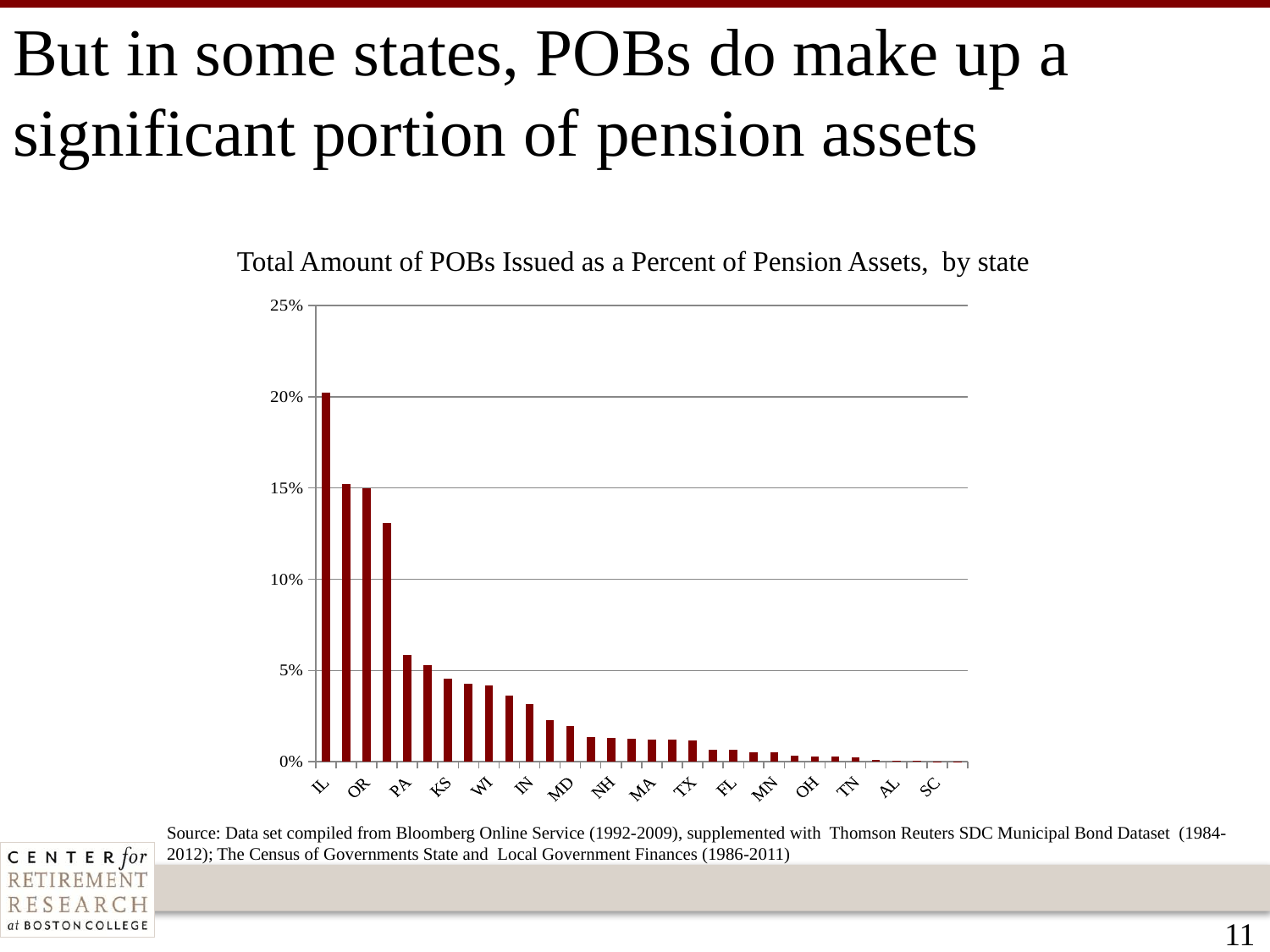
Is the value for IN greater or less than 5%? less Is the value for PA greater or less than 10%? less Is the value for IL greater or less than 15%? greater Which is larger, the value for PA or the value for OR? OR What is the title of the chart? Total Amount of POBs Issued as a Percent of Pension Assets, by state Which state has the highest value in the chart? IL Do the values rise or fall moving from left to right along the x axis? Fall Which is larger, the value for IL or the value for OR? IL What kind of chart is shown on the slide? Bar chart